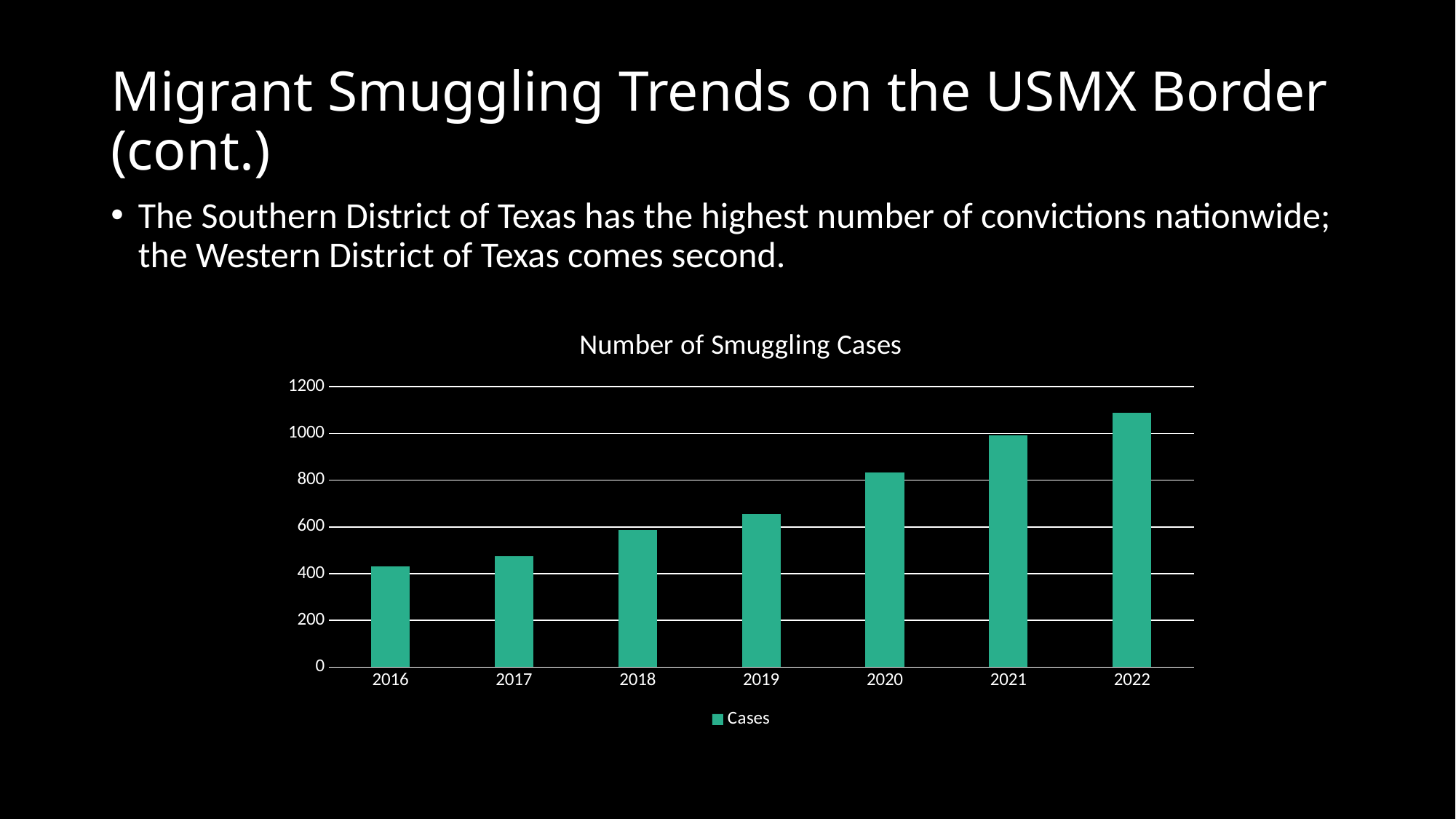
Is the value for 2017 greater or less than 600? less How many years are shown on the x axis of the chart? 7 Which year has the lowest number of smuggling cases? 2016 What is the title of the chart? Number of Smuggling Cases How many series does the chart legend list? 1 Is the value for 2022 greater or less than 1000? greater What is the name of the series shown in the chart legend? Cases Which year has the highest number of smuggling cases? 2022 Which year has more smuggling cases, 2018 or 2020? 2020 Do the number of smuggling cases rise or fall from 2016 to 2022? rise Is the value for 2019 greater or less than 600? greater What type of chart is shown on the slide? bar chart